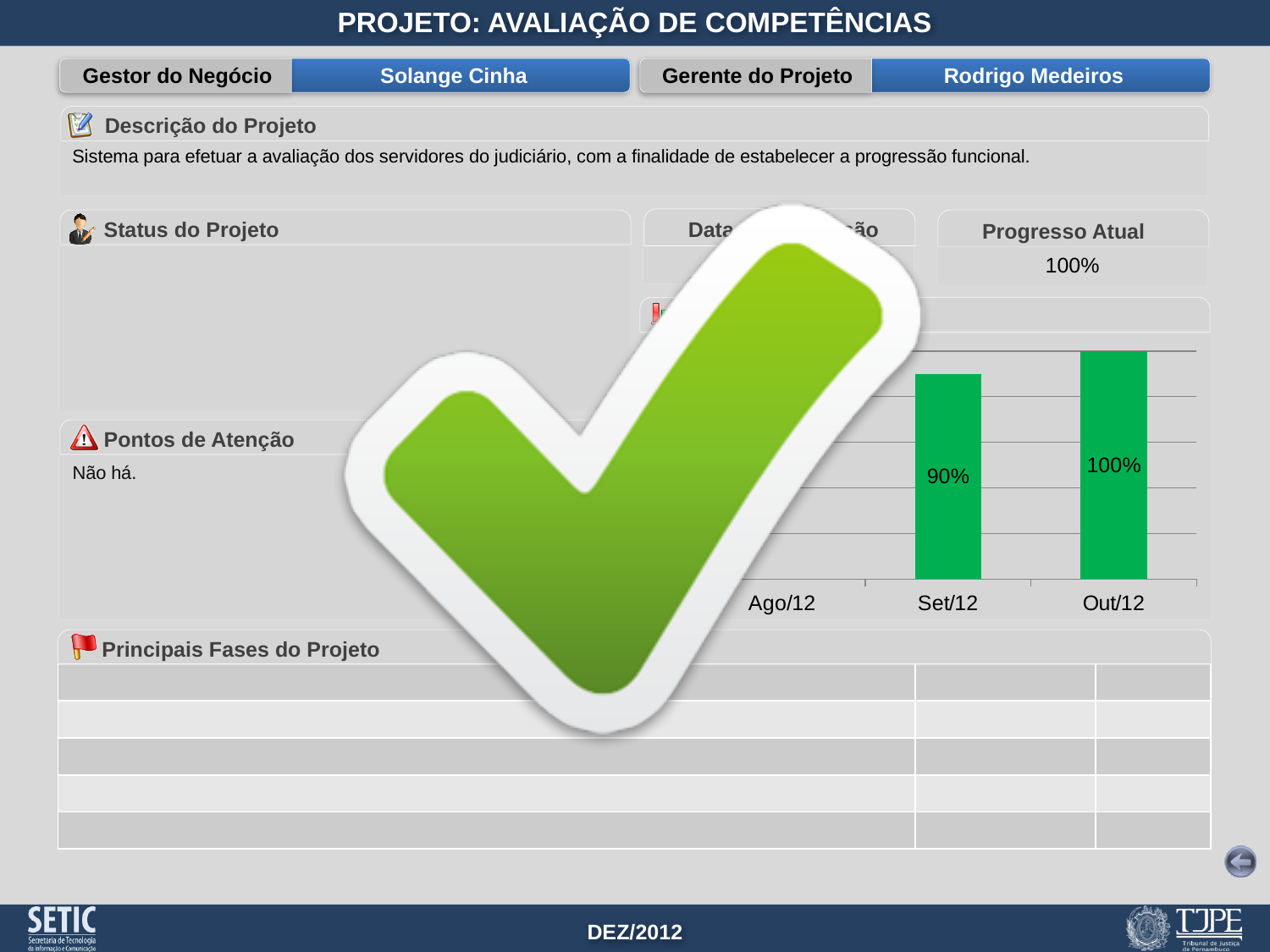
How many months are labelled on the x axis of the progress chart? 3 What is the first month label on the x axis of the progress chart? Ago/12 What colour are the bars in the progress chart? green Which is larger, the value for Set/12 or the value for Out/12? Out/12 What is the value shown for Set/12 in the progress chart? 90% What is the difference between the values for Out/12 and Set/12? 10% What kind of chart is used to show the project progress? bar chart Do the values rise or fall from Set/12 to Out/12? rise What is the value shown for Out/12 in the progress chart? 100% Which month has the highest value in the progress chart? Out/12